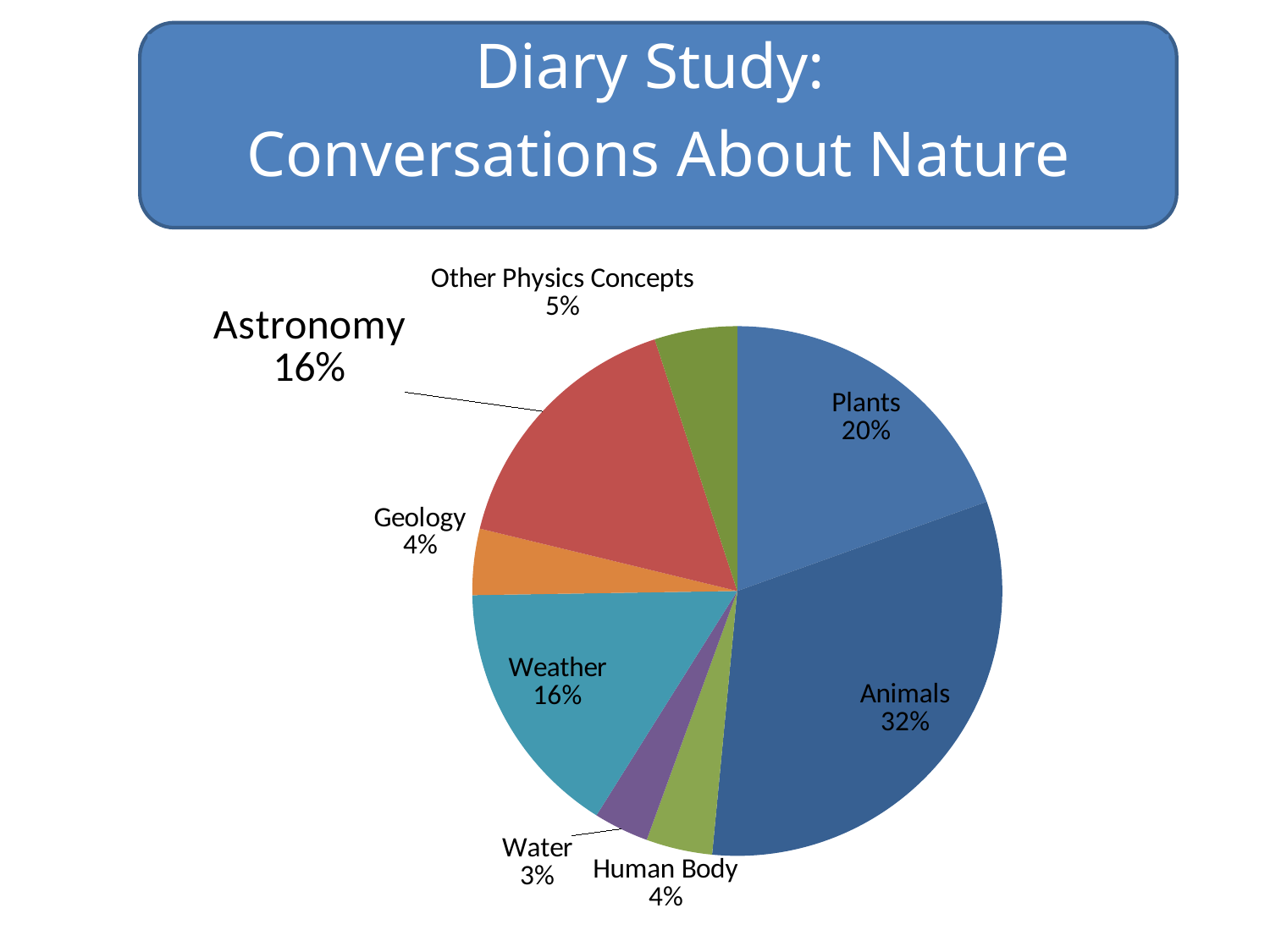
What is the combined percentage of Water and Human Body? 7% What is the title of the slide containing the chart? Diary Study: Conversations About Nature What is the value shown for Astronomy? 16% How many categories are shown in the pie chart? 8 What share of the pie does Animals take? 32% What is the value shown for Plants? 20% Which category has the largest slice of the pie? Animals Which is larger, the Weather slice or the Geology slice? Weather What is the difference between the Animals and Plants percentages? 12% What kind of chart is shown on the slide? pie chart What is the value shown for Other Physics Concepts? 5% Which category has the smallest slice of the pie? Water